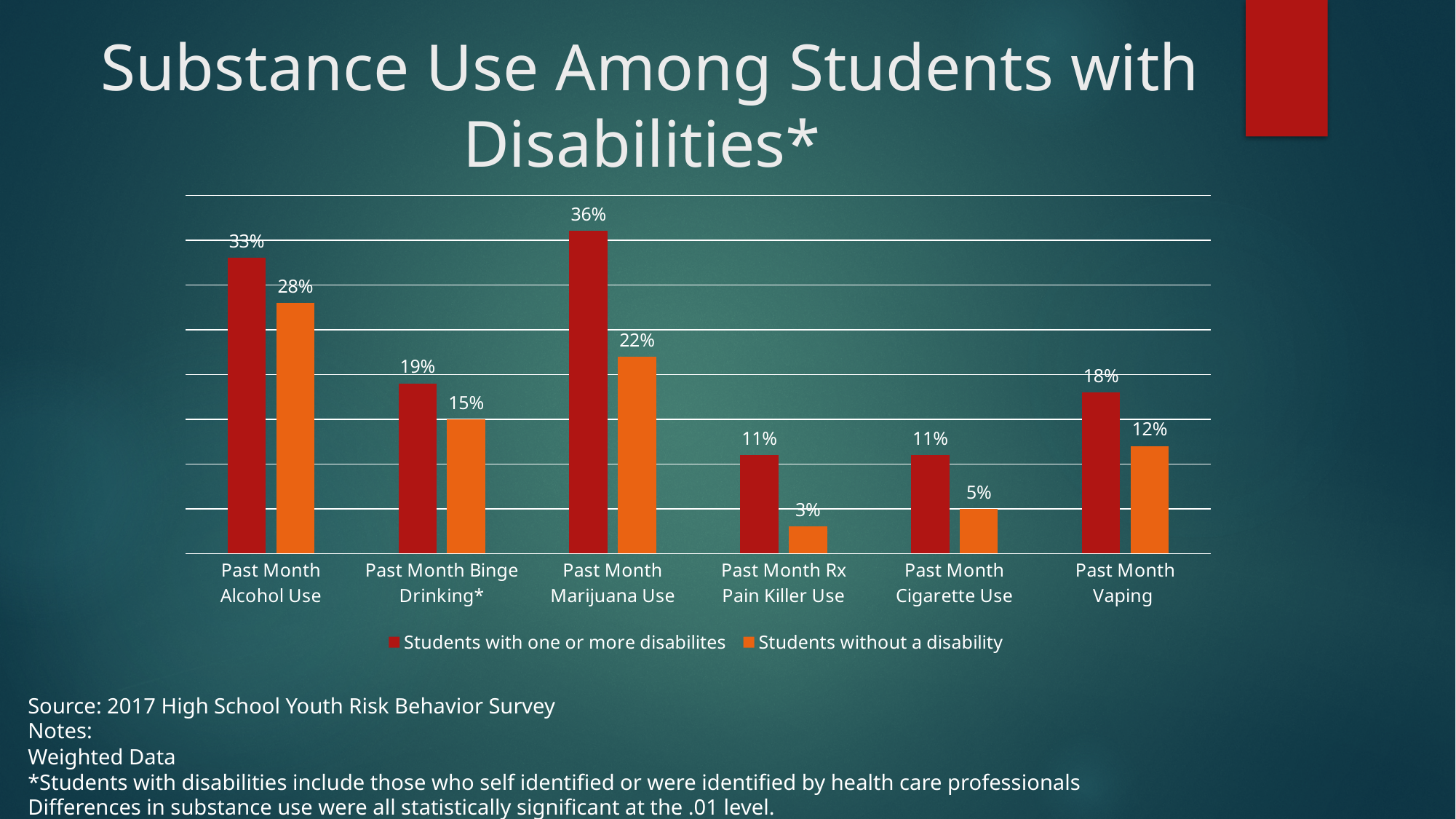
Which colour represents Students without a disability in the legend? Orange What is the difference between Students with one or more disabilites and Students without a disability for Past Month Marijuana Use? 14% What is the value for Past Month Rx Pain Killer Use among Students without a disability? 3% What is the value for Past Month Marijuana Use among Students with one or more disabilites? 36% What is the difference between Students with one or more disabilites and Students without a disability for Past Month Alcohol Use? 5% Which category has the highest value for Students with one or more disabilites? Past Month Marijuana Use Which category has the lowest value for Students without a disability? Past Month Rx Pain Killer Use How many series does the legend list? 2 Which is larger: Past Month Cigarette Use for Students without a disability or Past Month Vaping for Students without a disability? Past Month Vaping How many categories are shown on the x axis? 6 What kind of chart is shown on the slide? Bar chart What is the value for Past Month Vaping among Students without a disability? 12%